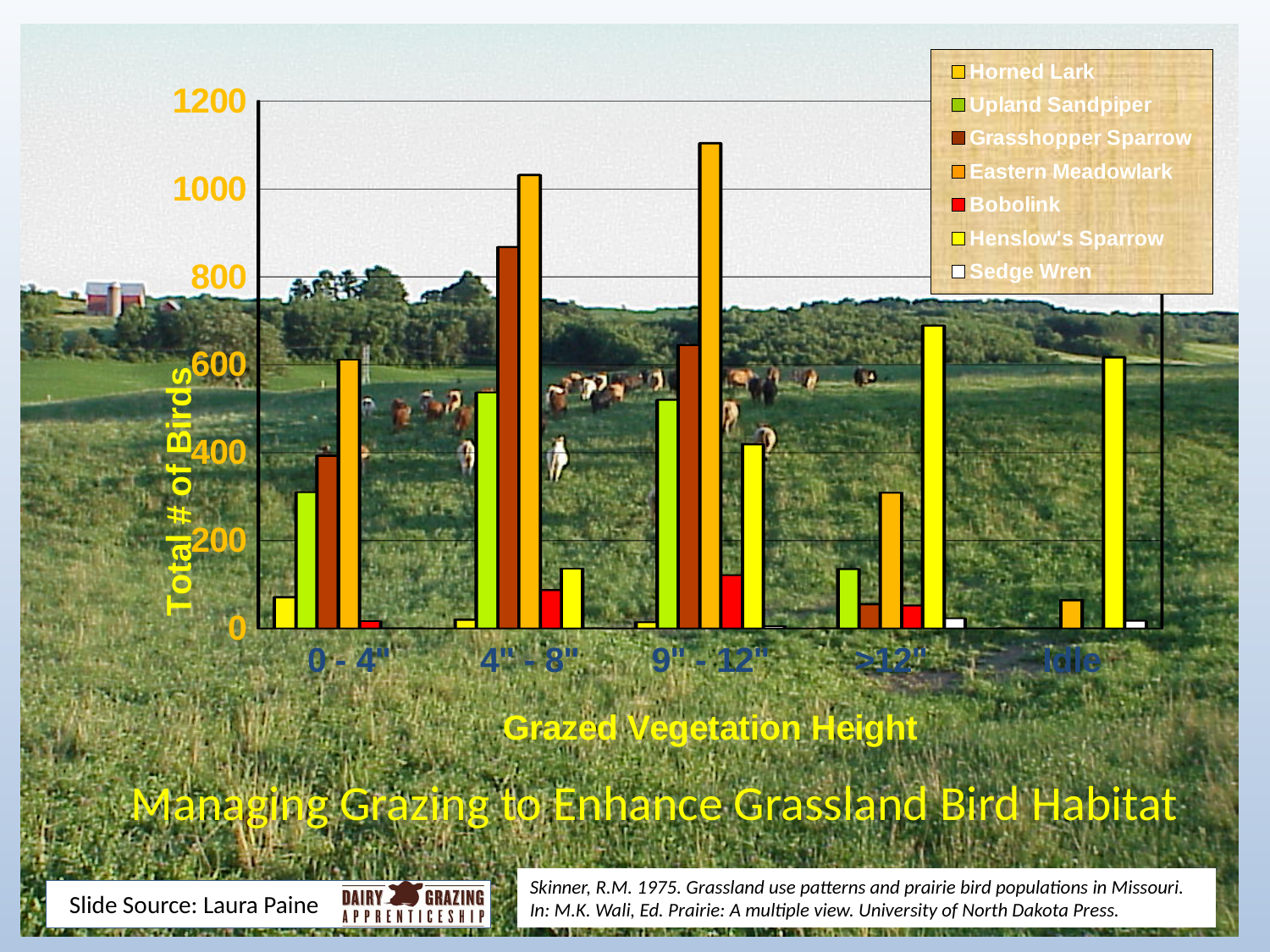
Is the value for Henslow's Sparrow in the >12" category greater or less than 800? less Is the value for Grasshopper Sparrow in the 4" - 8" category greater or less than 800? greater What is the title of the x axis? Grazed Vegetation Height Is the value for Bobolink in the 9" - 12" category greater or less than 200? less What is the title of the y axis? Total # of Birds How many bird species does the legend list? 7 Which bird species has the highest value in the 4" - 8" category? Eastern Meadowlark How many vegetation height categories are shown on the x axis? 5 What kind of chart is shown on the slide? bar chart Is the Grasshopper Sparrow value larger in the 4" - 8" category or the 9" - 12" category? 4" - 8" Which bird species has the highest value in the >12" category? Henslow's Sparrow